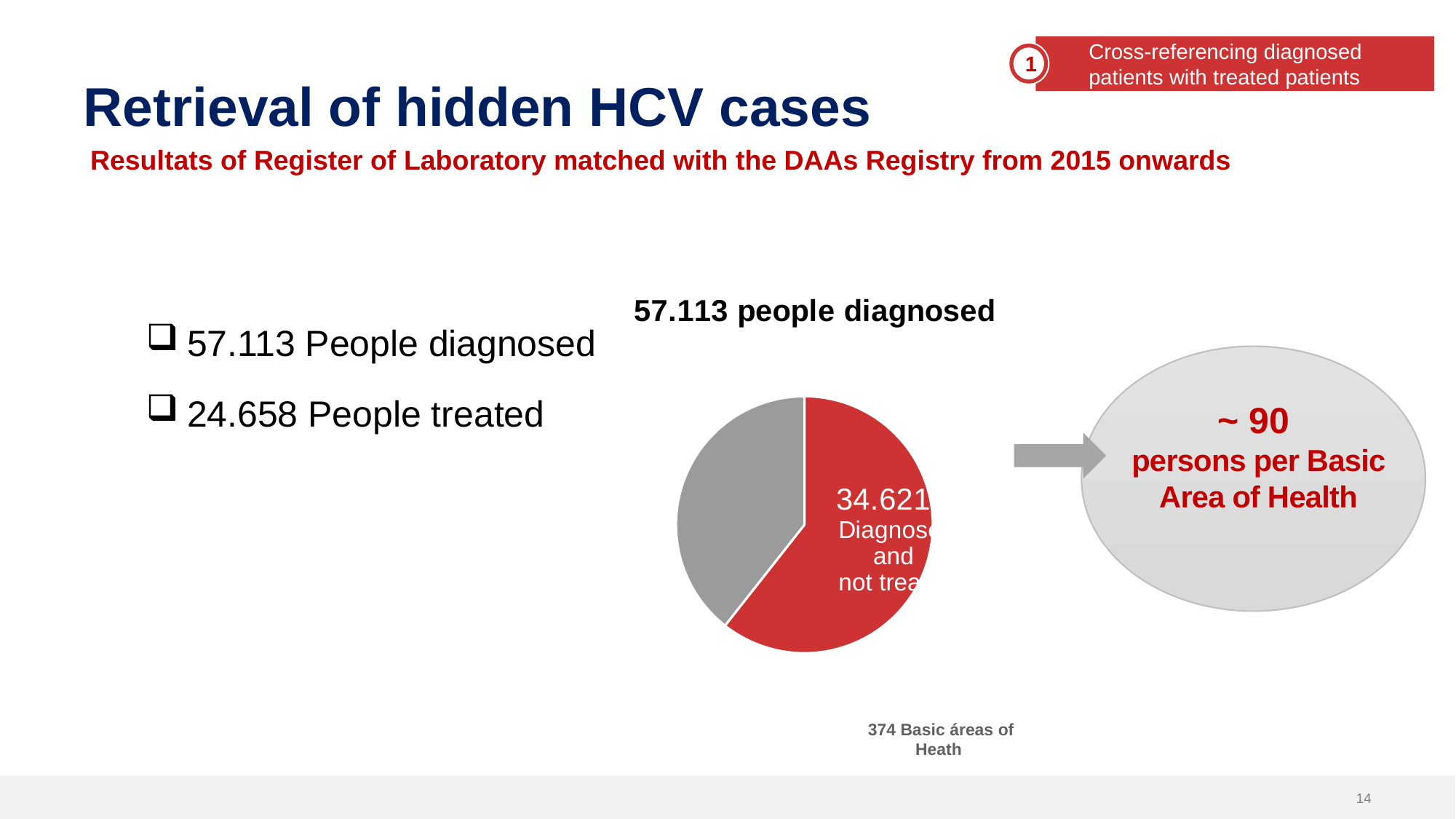
Which slice of the pie chart is larger, the red one or the grey one? The red one What is the title of the pie chart? 57.113 people diagnosed How many slices does the pie chart have? 2 Which slice of the pie chart is the smallest? The grey slice What total number of people diagnosed does the pie chart title state? 57.113 What kind of chart is shown on the slide? Pie chart What does the red slice of the pie chart represent? Diagnosed and not treated How many people diagnosed and not treated are shown in the pie chart? 34.621 Does the red 'Diagnosed and not treated' slice represent more or less than half of the pie? More What value is printed on the red slice of the pie chart? 34.621